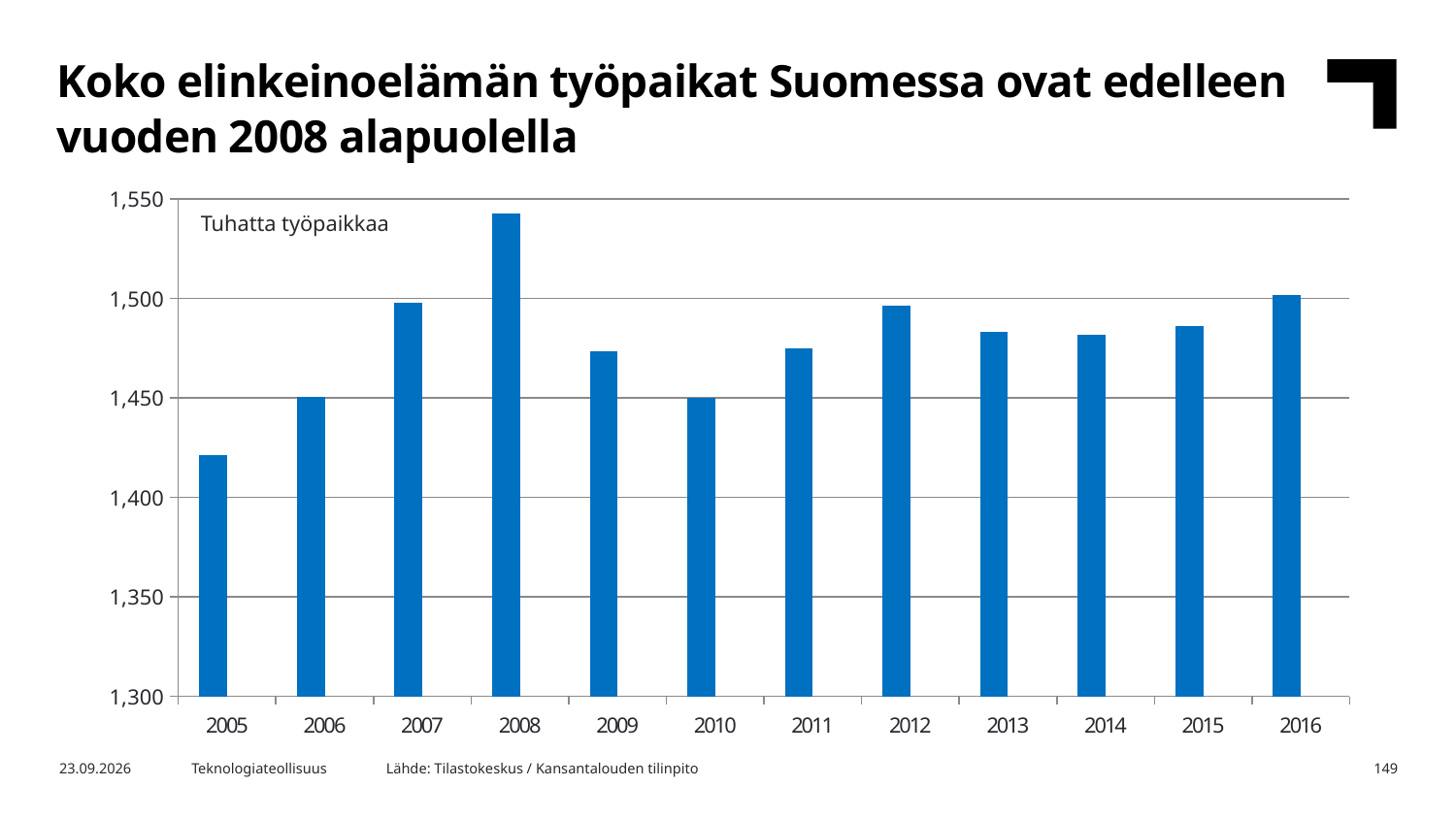
Which year has the larger value, 2005 or 2006? 2006 Which year has the larger value, 2008 or 2016? 2008 How many years are shown on the x axis of the chart? 12 Is the value for 2005 greater or less than 1,450? less Is the value for 2013 greater or less than 1,500? less What unit label is shown inside the chart area? Tuhatta työpaikkaa Which year has the lowest number of jobs in the chart? 2005 Is the value for 2008 greater or less than 1,500? greater What kind of chart is shown on the slide? bar chart Which year has the highest number of jobs in the chart? 2008 Do the values rise or fall from 2005 to 2008? rise